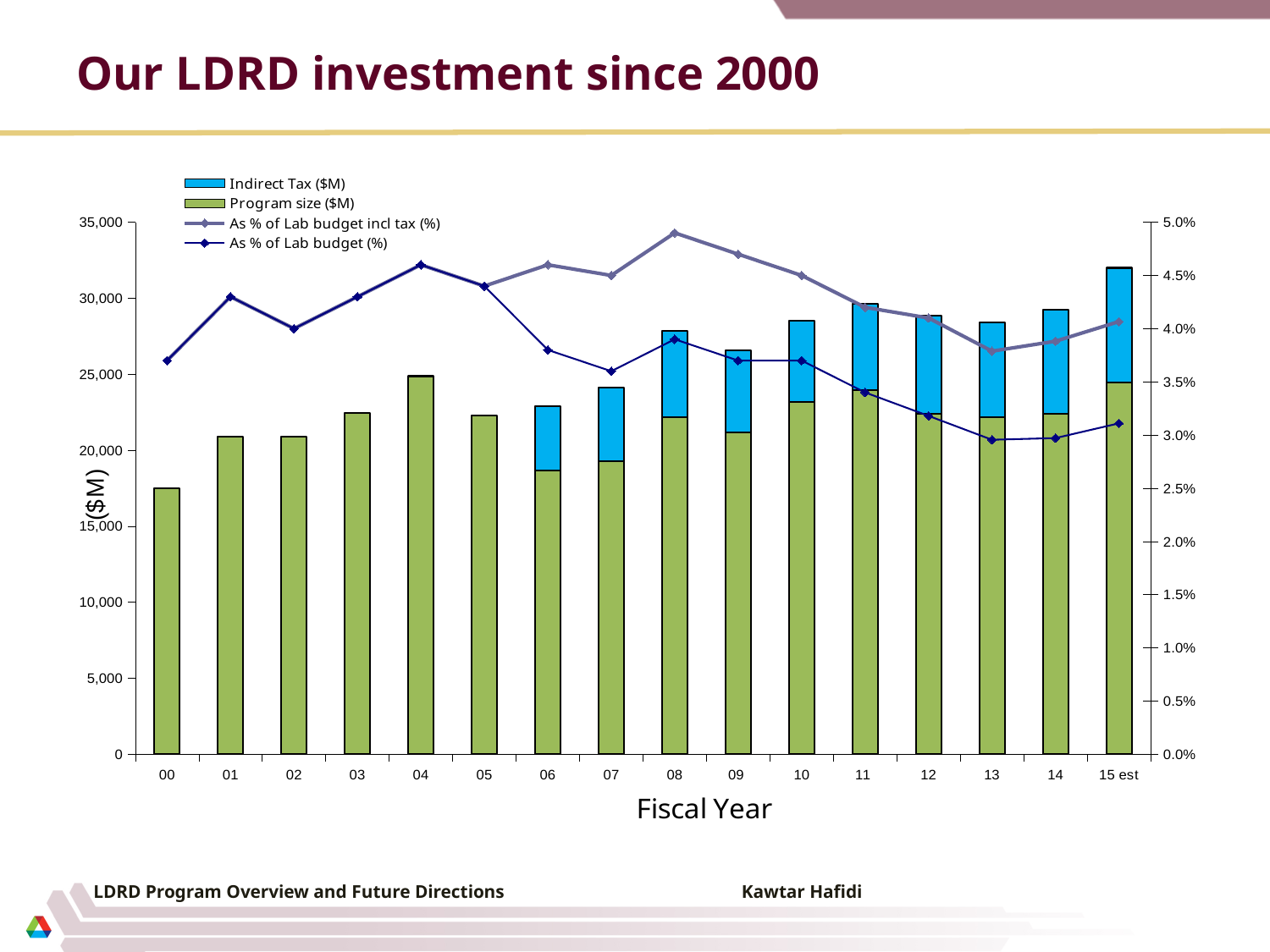
In which fiscal year does the 'As % of Lab budget incl tax (%)' line reach its highest point? 08 Which fiscal year has the shortest bar? 00 Which fiscal year has the tallest stacked bar (Program size plus Indirect Tax)? 15 est What kind of chart is shown on the slide? A combination of a stacked bar chart and a line chart How many series does the chart's legend list? 4 Is the Program size ($M) for fiscal year 00 greater or less than 20,000? less Is the 'As % of Lab budget (%)' value for fiscal year 13 greater or less than 3.5%? less In which fiscal year does the 'As % of Lab budget (%)' line reach its highest point? 04 Which is larger, the Program size ($M) bar for fiscal year 00 or for fiscal year 01? 01 Is the total stacked bar for fiscal year 15 est greater or less than 30,000? greater Does the 'As % of Lab budget (%)' line rise or fall from fiscal year 10 to fiscal year 13? fall How many fiscal years are shown on the x axis of the chart? 16